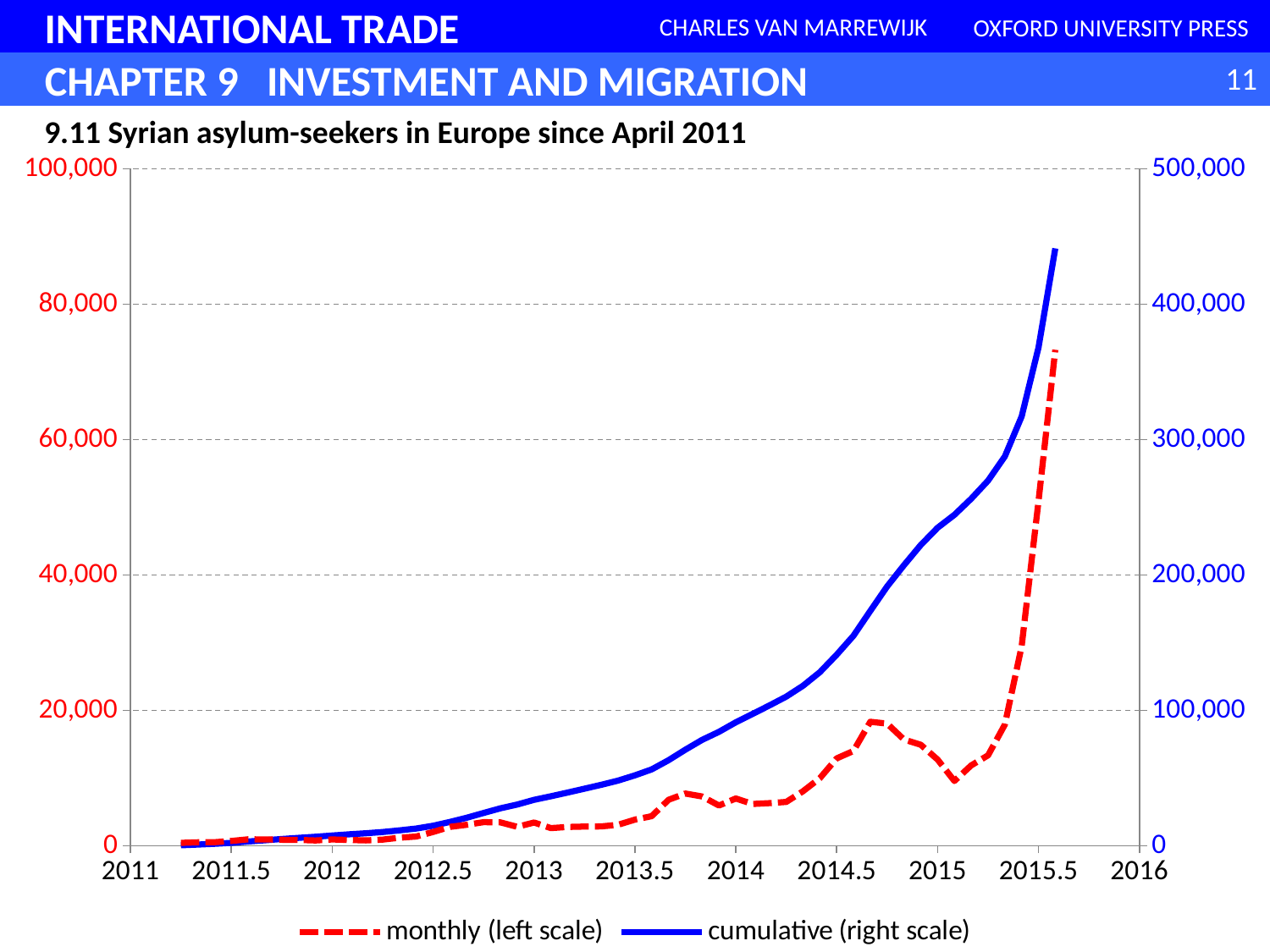
Is the cumulative value at 2013 greater or less than 100,000? less Is the monthly value at 2014 greater or less than 20,000? less Does the cumulative line rise or fall as you move from 2011 to 2016 along the x axis? rise Is the cumulative value at 2015 greater or less than 200,000? greater Which axis scale does the cumulative series use, according to the legend? right scale How many series does the legend list? 2 What kind of chart is shown on the slide? line chart What is the title of the chart? 9.11 Syrian asylum-seekers in Europe since April 2011